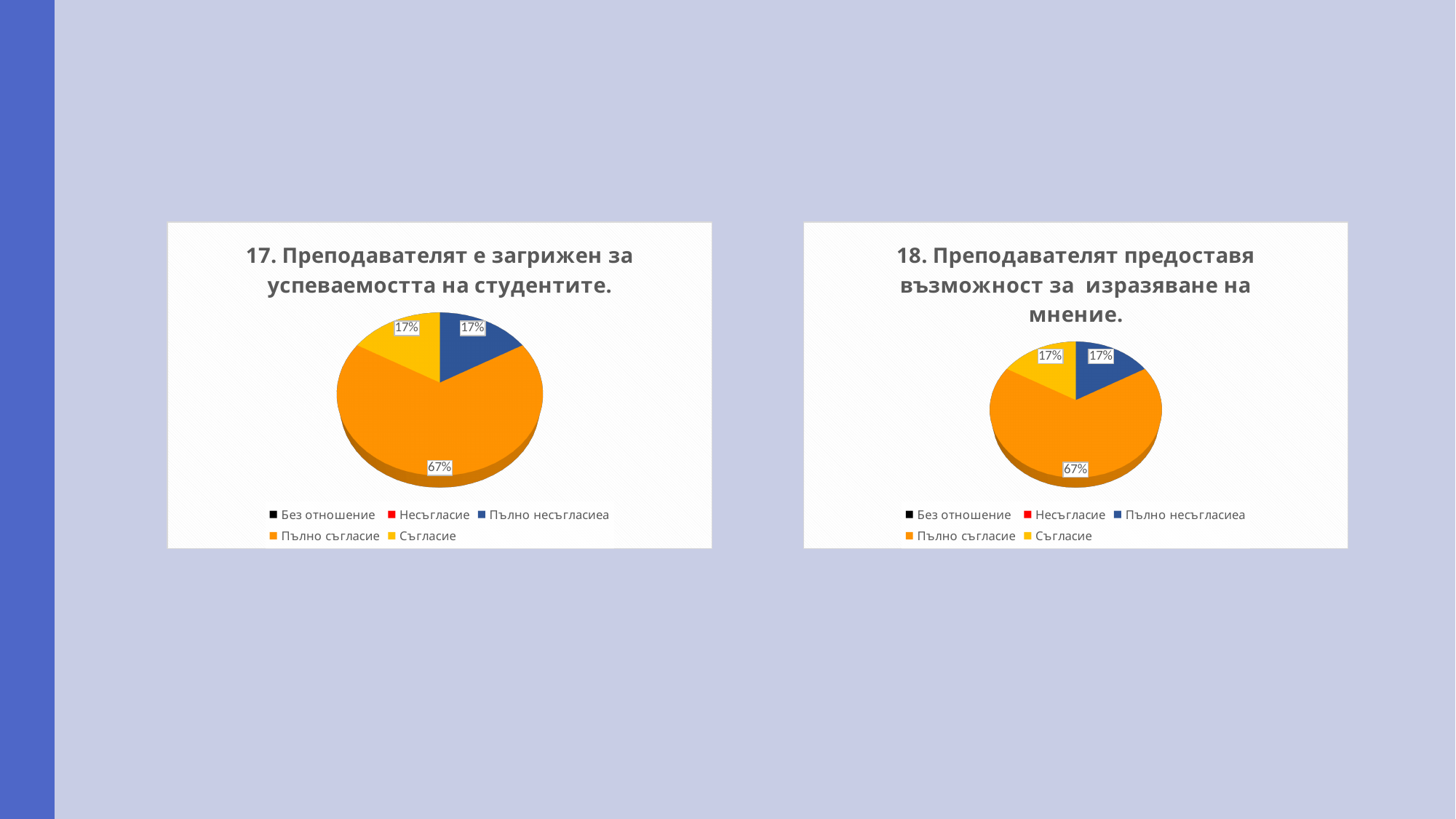
How many entries does the legend of the left chart (17. Преподавателят е загрижен за успеваемостта на студентите.) list? 5 In the left chart (17. Преподавателят е загрижен за успеваемостта на студентите.), what share does Пълно съгласие have? 67% What type of chart is the right chart (18. Преподавателят предоставя възможност за изразяване на мнение.)? Pie chart In the left chart (17. Преподавателят е загрижен за успеваемостта на студентите.), what colour is the Съгласие slice? Yellow In the right chart (18. Преподавателят предоставя възможност за изразяване на мнение.), what share does Пълно несъгласиеа have? 17% In the right chart (18. Преподавателят предоставя възможност за изразяване на мнение.), which category has the largest slice? Пълно съгласие In the right chart (18. Преподавателят предоставя възможност за изразяване на мнение.), what share does Пълно съгласие have? 67% How many charts are shown on the slide? 2 In the right chart (18. Преподавателят предоставя възможност за изразяване на мнение.), which is larger: Пълно съгласие or Пълно несъгласиеа? Пълно съгласие In the left chart (17. Преподавателят е загрижен за успеваемостта на студентите.), which category has the largest slice? Пълно съгласие In the left chart (17. Преподавателят е загрижен за успеваемостта на студентите.), what is the difference between the Пълно съгласие share and the Съгласие share? 50% In the left chart (17. Преподавателят е загрижен за успеваемостта на студентите.), what share does Съгласие have? 17%